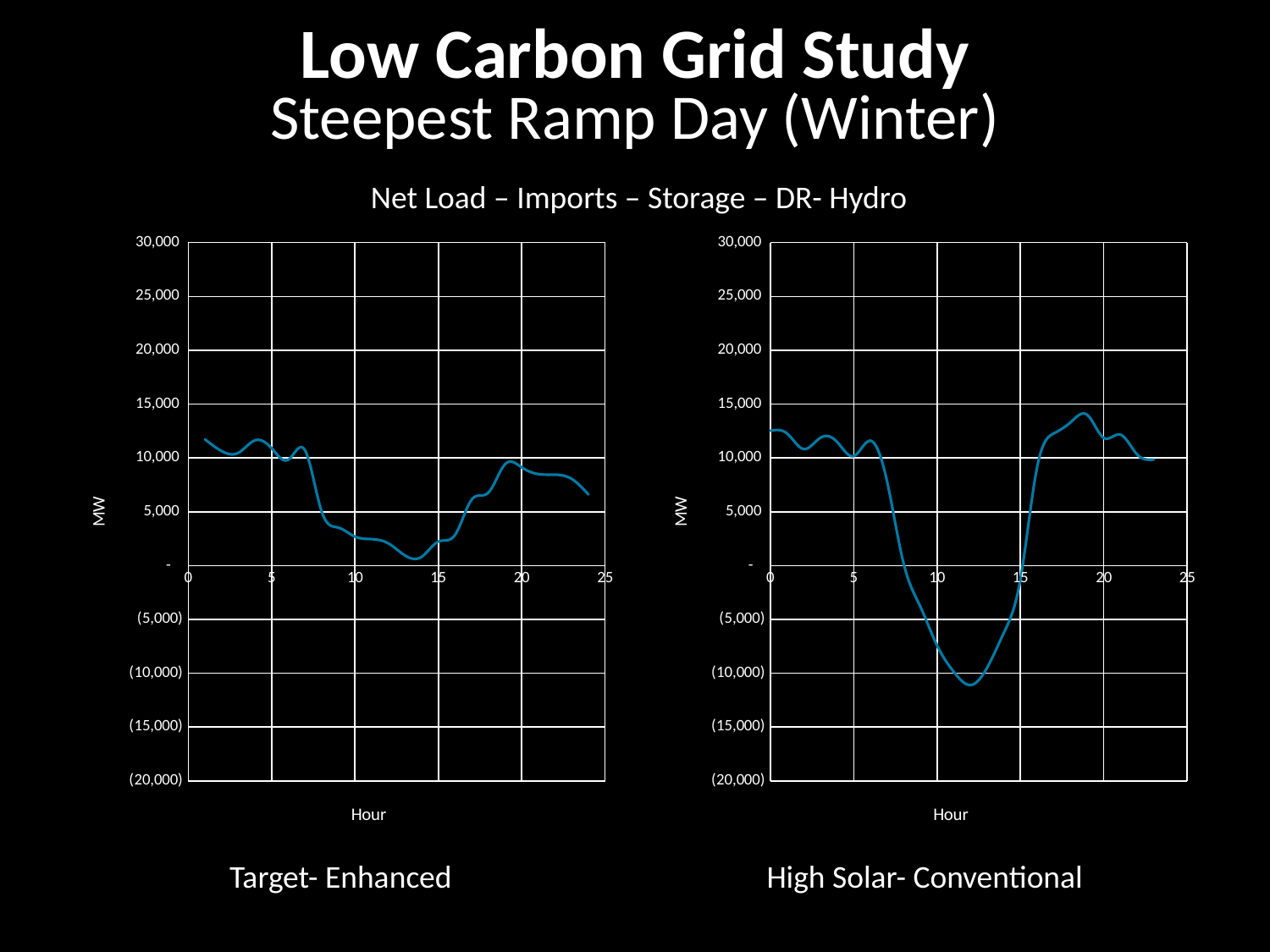
What kind of chart is the Target- Enhanced chart on the left? line chart What kind of chart is the High Solar- Conventional chart on the right? line chart In the High Solar- Conventional chart, is the value at hour 12 greater or less than (5,000)? less In the High Solar- Conventional chart, does the line rise or fall between hour 6 and hour 12? fall In the High Solar- Conventional chart, is the value at hour 19 greater or less than 10,000? greater In the Target- Enhanced chart, does the line rise or fall between hour 7 and hour 14? fall What is the label on the vertical axis of both charts? MW How many charts are shown on the slide? 2 In the Target- Enhanced chart, is the value at hour 10 greater or less than 5,000? less Which chart reaches a lower minimum value, Target- Enhanced or High Solar- Conventional? High Solar- Conventional